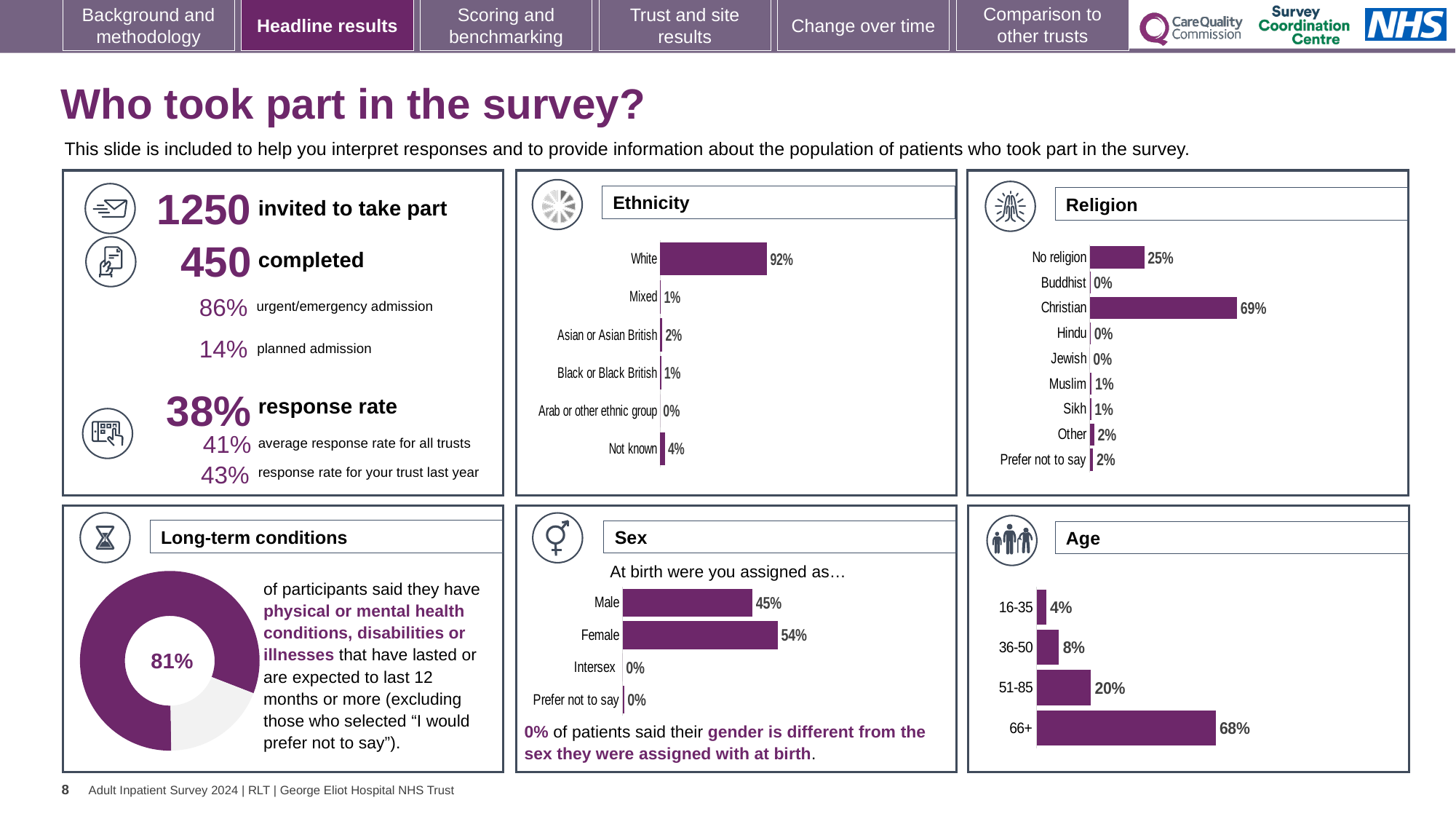
In the Age chart, which category has the lowest value? 16-35 In the Age chart, how many age categories are shown? 4 In the Age chart, what is the value for 66+? 68% In the Sex chart, what is the difference between the Female and Male values? 9% In the Ethnicity chart, what is the value for White? 92% In the Sex chart, which is larger, Male or Female? Female In the Long-term conditions chart, what share of participants said they have long-term conditions? 81% In the Ethnicity chart, how many categories are shown? 6 In the Age chart, what is the difference between the 51-85 and 36-50 values? 12% In the Religion chart, which category has the highest value? Christian What kind of chart is the Long-term conditions chart? Doughnut chart In the Religion chart, what is the value for No religion? 25%